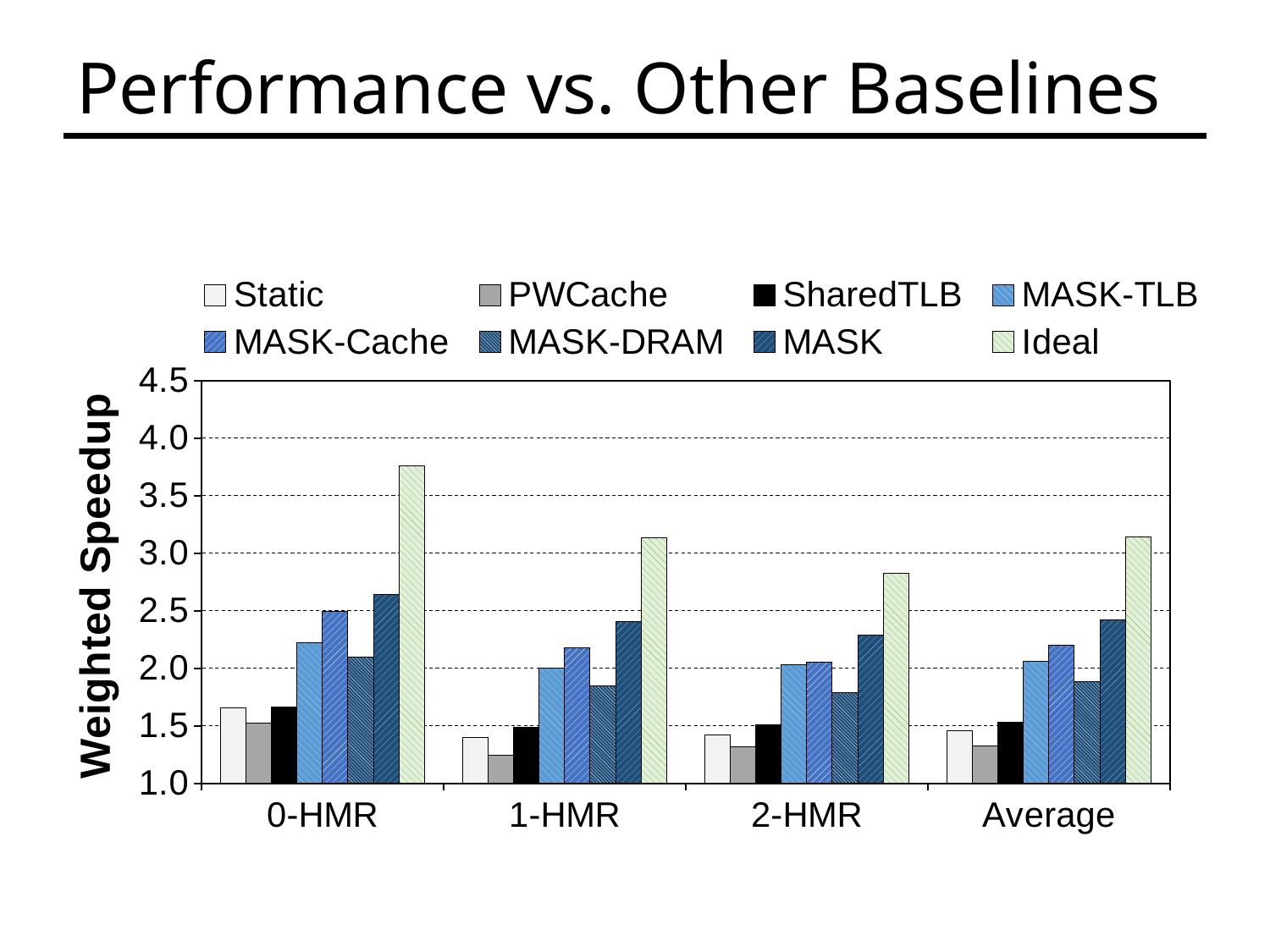
Is the value for PWCache at 1-HMR greater or less than 1.5? less Is the value for MASK at Average greater or less than 2.5? less How many categories are shown on the x axis? 4 For 2-HMR, which is larger: MASK or MASK-DRAM? MASK Which series has the lowest weighted speedup for 1-HMR? PWCache Is the value for Ideal at 0-HMR greater or less than 3.5? greater Does the Ideal series rise or fall from 0-HMR to 2-HMR? fall Which series has the highest weighted speedup for 0-HMR? Ideal How many series does the legend list? 8 What is the label of the y axis? Weighted Speedup What kind of chart is shown on the slide? bar chart What is the title of the slide? Performance vs. Other Baselines